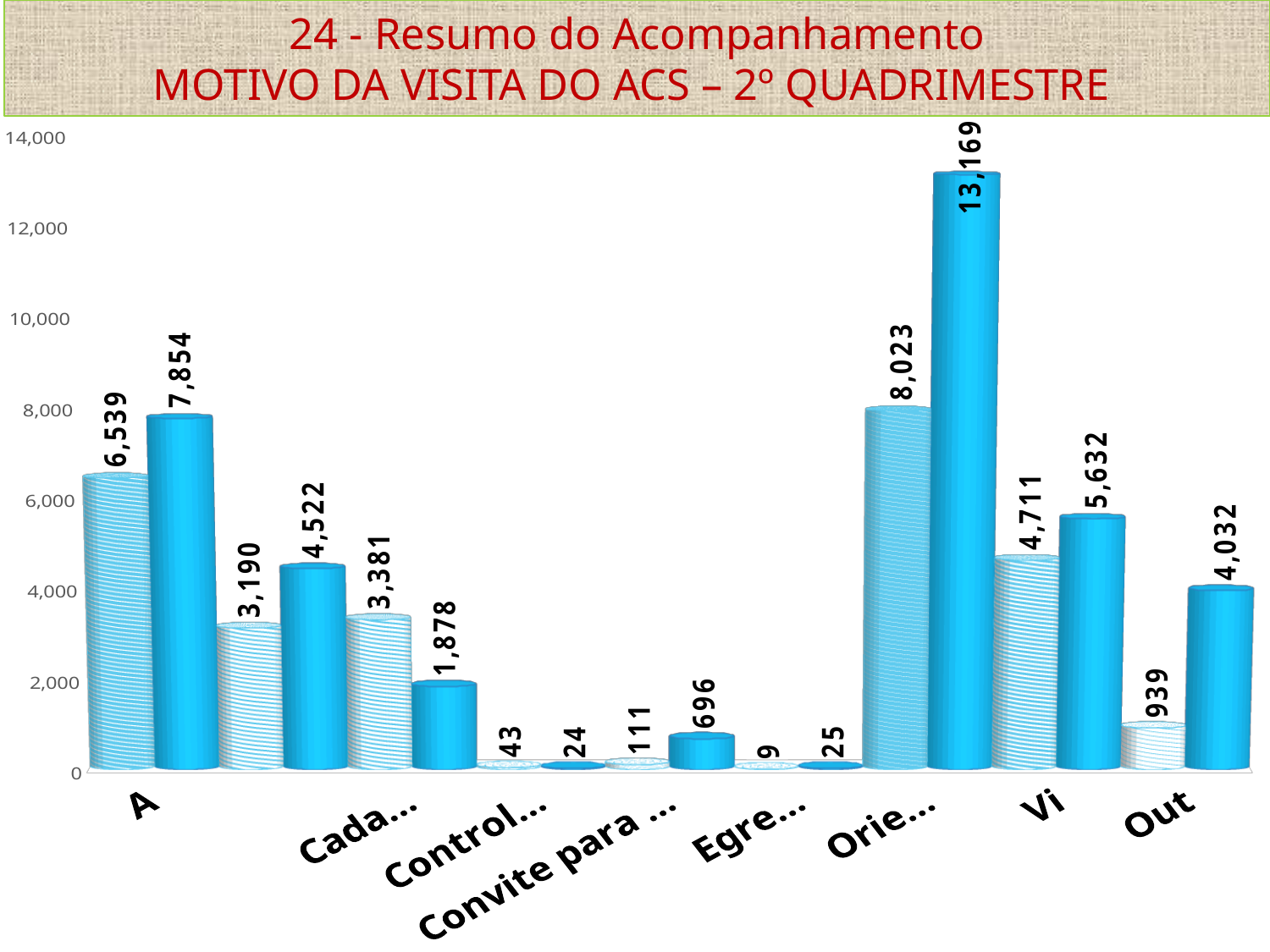
What is the difference between the two tallest bars, labelled 13,169 and 8,023? 5,146 Is the tallest bar on the chart greater or less than 12,000? greater What are the values of the two bars for the first category, labelled "A"? 6,539 and 7,854 What is the highest value shown on the chart? 13,169 What is the difference between the bars labelled 5,632 and 4,711? 921 How many bars are plotted on the chart in total? 18 What is the difference between the two bars of the last category, labelled 4,032 and 939? 3,093 For the category "A", which of its two bars is larger, 6,539 or 7,854? 7,854 What is the lowest value labelled on the chart? 9 What is the title of the slide? 24 - Resumo do Acompanhamento MOTIVO DA VISITA DO ACS – 2º QUADRIMESTRE What kind of chart is shown on the slide? bar chart